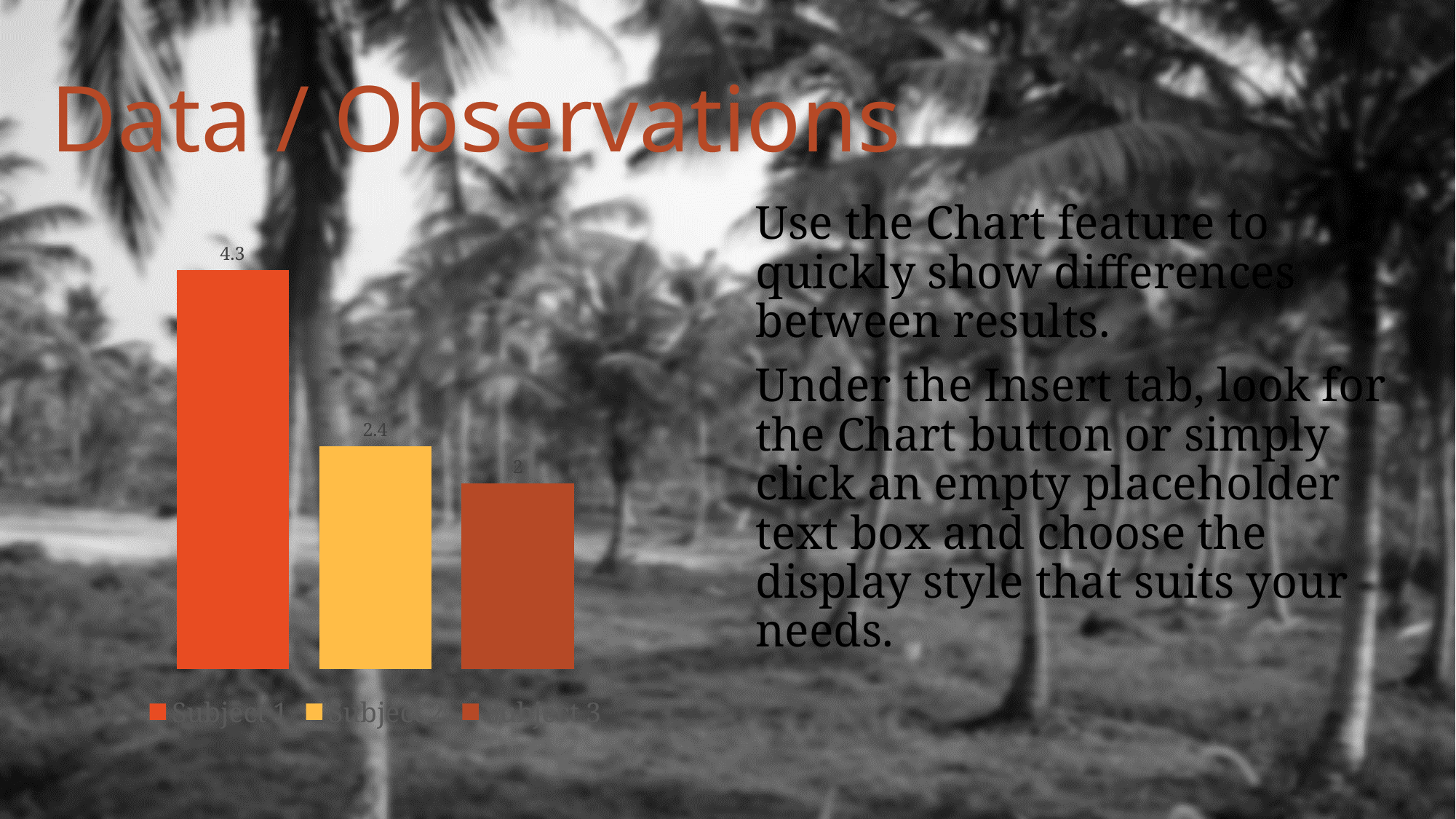
What is the difference between the values for Subject 1 and Subject 2? 1.9 What is the value for Subject 2? 2.4 What is the value for Subject 3? 2 Which subject has the highest value? Subject 1 Which subject has the lowest value? Subject 3 How many bars are plotted in the chart? 3 Do the bar values rise or fall from left to right? Fall What kind of chart is shown on the slide? Bar chart How many entries does the legend list? 3 Which is larger, the value for Subject 1 or the value for Subject 3? Subject 1 What is the difference between the values for Subject 2 and Subject 3? 0.4 What is the value for Subject 1? 4.3